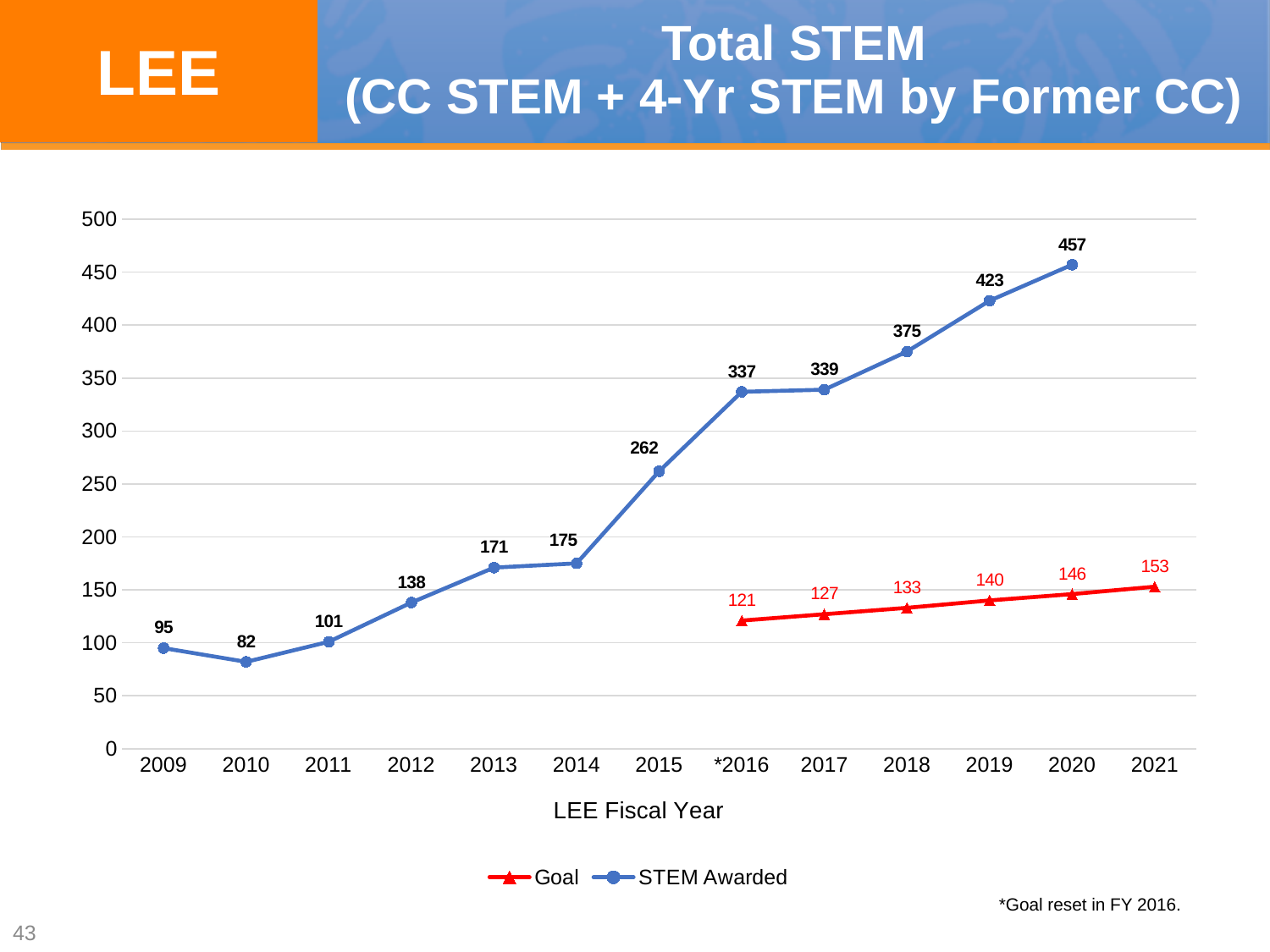
Which is larger in 2018, STEM Awarded or the Goal? STEM Awarded Does the Goal series rise or fall from 2016 to 2021? Rise What kind of chart is shown? Line chart How many series does the legend list? 2 What is the Goal value for 2021? 153 In which year was STEM Awarded highest? 2020 In which year was STEM Awarded lowest? 2010 How many years are shown on the x axis? 13 What is the difference between STEM Awarded and the Goal in 2019? 283 What is the x-axis label of the chart? LEE Fiscal Year What was the STEM Awarded value in 2015? 262 What was the STEM Awarded value in 2020? 457